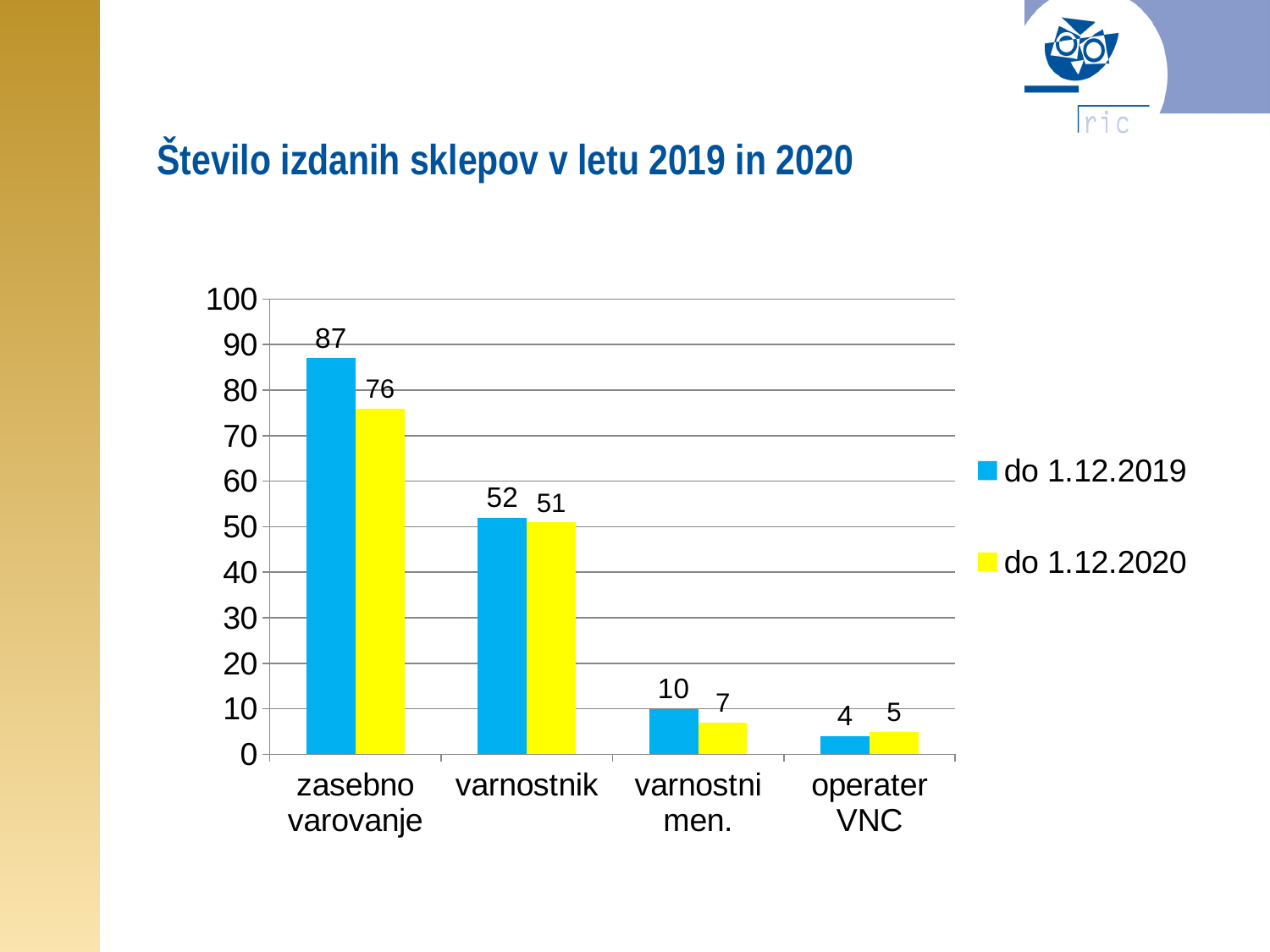
What is the difference between the do 1.12.2019 and do 1.12.2020 values for zasebno varovanje? 11 What is the value for operater VNC in the do 1.12.2019 series? 4 What colour represents the do 1.12.2020 series? yellow How many series does the legend list? 2 For varnostni men., which series has the larger value, do 1.12.2019 or do 1.12.2020? do 1.12.2019 What is the value for varnostnik in the do 1.12.2020 series? 51 Is the do 1.12.2020 value for varnostnik greater or less than 60? less Which category has the highest value in the do 1.12.2020 series? zasebno varovanje Which category has the lowest value in the do 1.12.2019 series? operater VNC How many categories are shown on the x axis? 4 What kind of chart is shown on the slide? bar chart What is the value for zasebno varovanje in the do 1.12.2019 series? 87